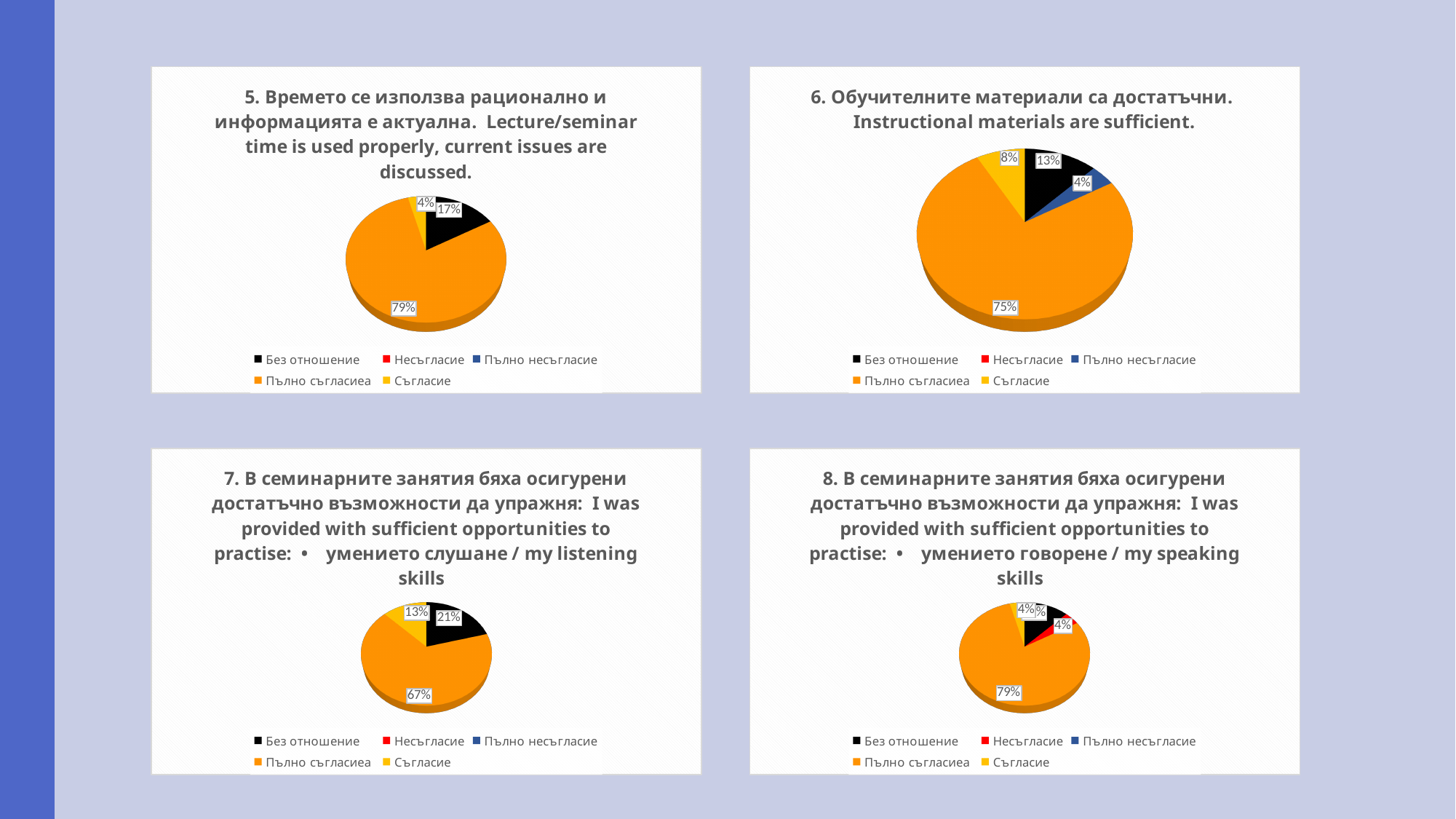
In the chart titled "5. Времето се използва рационално и информацията е актуална", what colour is the slice labelled 79%? Orange In the chart titled "6. Обучителните материали са достатъчни", what percentage is shown for the yellow slice (Съгласие)? 8% In the chart titled "7. ... my listening skills", what percentage is shown for the black slice (Без отношение)? 21% In the chart titled "6. Обучителните материали са достатъчни", which category has the largest share? Пълно съгласиеа In the chart titled "7. ... my listening skills", what is the difference between the orange slice (67%) and the yellow slice (13%)? 54% In the chart titled "7. ... my listening skills", which is larger: the black slice (Без отношение) or the yellow slice (Съгласие)? Без отношение In the chart titled "6. Обучителните материали са достатъчни", what percentage is shown for the blue slice (Пълно несъгласие)? 4% How many entries does the legend list in the chart titled "5. Времето се използва рационално и информацията е актуална"? 5 In the chart titled "8. ... my speaking skills", what percentage is shown for the orange slice (Пълно съгласие)? 79% In the chart titled "5. Времето се използва рационално и информацията е актуална", what percentage is shown for the black slice (Без отношение)? 17% In the chart titled "5. Времето се използва рационално и информацията е актуална", what percentage is shown for the orange slice (Пълно съгласие)? 79% What type of chart is used in the chart titled "6. Обучителните материали са достатъчни"? Pie chart